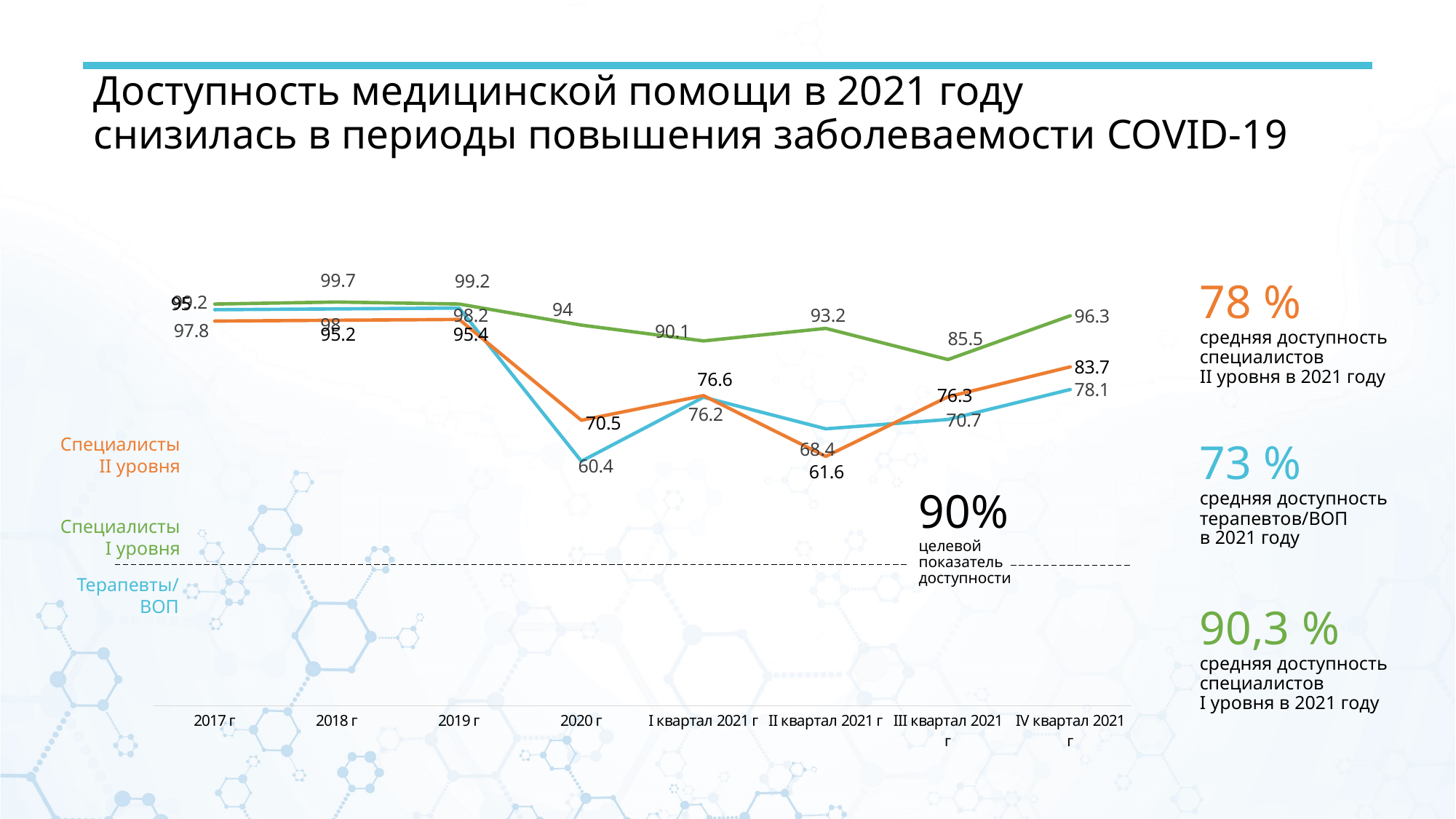
What kind of chart is shown on the slide? line chart Which series has the larger value in II квартал 2021 г: Специалисты II уровня or Терапевты/ВОП? Терапевты/ВОП What is the value for Терапевты/ВОП in 2020 г? 60.4 What is the value for Специалисты I уровня in III квартал 2021 г? 85.5 How many series does the chart's legend list? 3 What target accessibility indicator (целевой показатель доступности) is marked on the chart? 90% What is the value for Специалисты II уровня in II квартал 2021 г? 61.6 In which period is the value for Специалисты I уровня the highest? 2018 г How many points are plotted along the x axis of the chart? 8 What is the difference between the Специалисты II уровня value and the Терапевты/ВОП value in 2020 г? 10.1 What is the value for Специалисты I уровня in IV квартал 2021 г? 96.3 In which period is the value for Специалисты I уровня the lowest? III квартал 2021 г